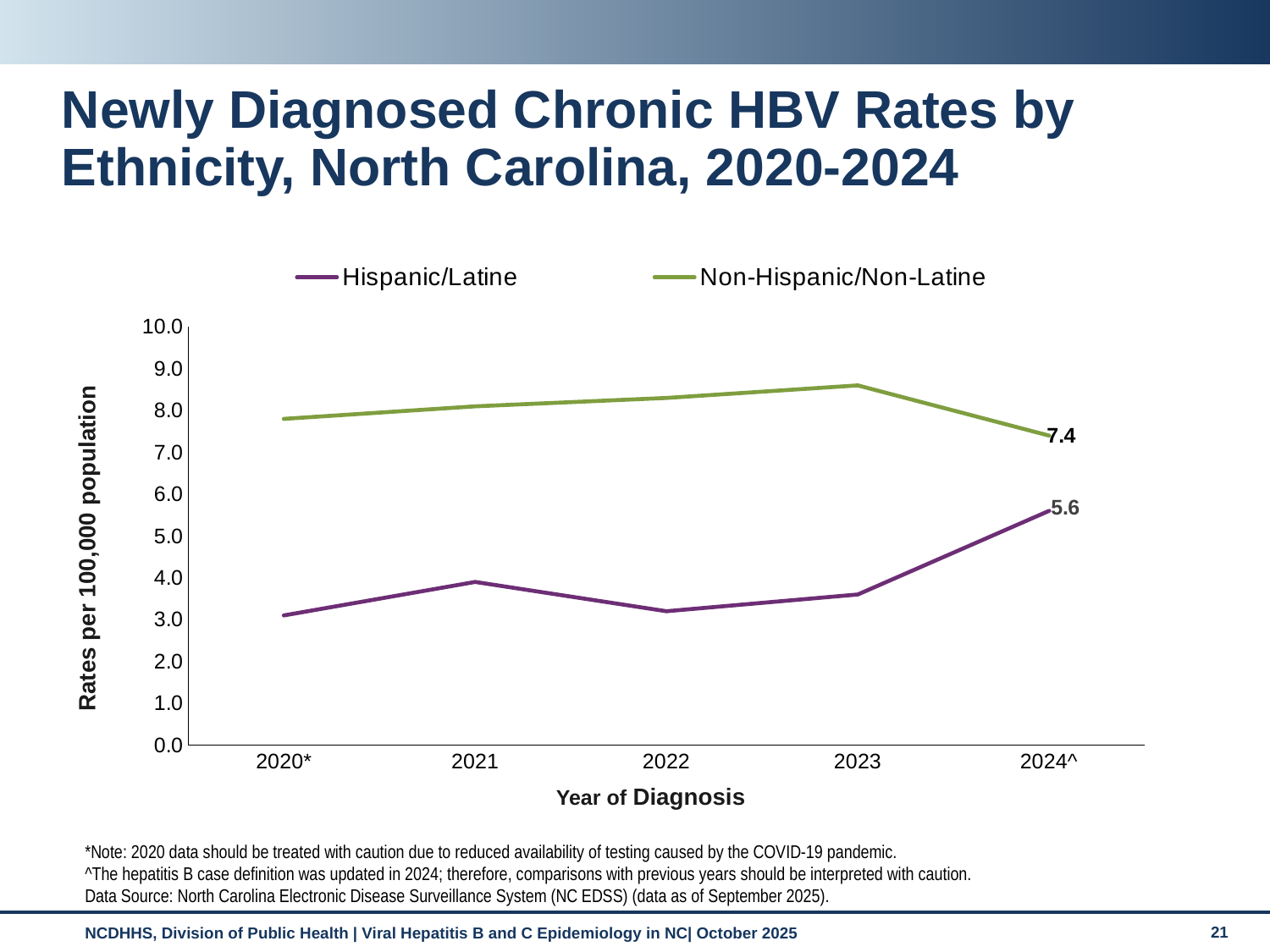
What is the difference between the Non-Hispanic/Non-Latine and Hispanic/Latine rates in 2024^? 1.8 How many years are shown on the x axis? 5 In which year is the Hispanic/Latine rate highest? 2024^ What is the Non-Hispanic/Non-Latine rate in 2024^? 7.4 What is the Hispanic/Latine rate in 2024^? 5.6 How many series does the legend list? 2 What kind of chart is shown on the slide? line chart In which year is the Non-Hispanic/Non-Latine rate highest? 2023 Is the Hispanic/Latine rate in 2022 greater or less than 4.0? less Is the Hispanic/Latine rate in 2020* greater or less than 4.0? less Which series has the higher rate in 2024^, Hispanic/Latine or Non-Hispanic/Non-Latine? Non-Hispanic/Non-Latine Is the Non-Hispanic/Non-Latine rate in 2023 greater or less than 8.0? greater